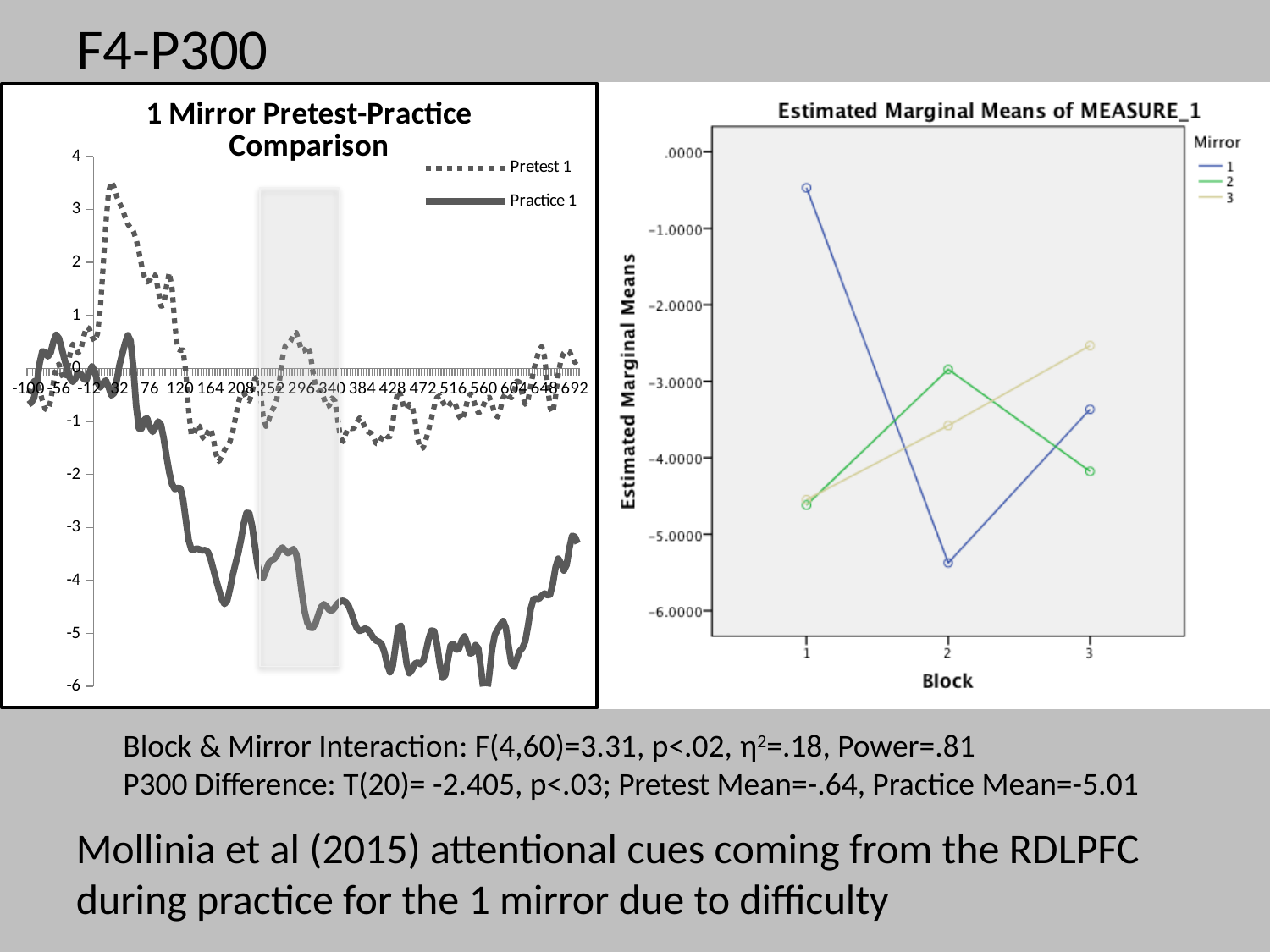
In the right chart 'Estimated Marginal Means of MEASURE_1', does the Mirror 3 line rise or fall from Block 1 to Block 3? rise How many series does the legend of the left chart '1 Mirror Pretest-Practice Comparison' list? 2 In the left chart '1 Mirror Pretest-Practice Comparison', which series reaches the lowest value overall? Practice 1 How many Block categories are shown on the x axis of the right chart 'Estimated Marginal Means of MEASURE_1'? 3 In the right chart 'Estimated Marginal Means of MEASURE_1', which Mirror has the lowest value at Block 2? Mirror 1 What is the title of the chart on the right? Estimated Marginal Means of MEASURE_1 In the right chart 'Estimated Marginal Means of MEASURE_1', is the value for Mirror 1 at Block 2 greater or less than -5.0000? less What kind of chart is the '1 Mirror Pretest-Practice Comparison' chart on the left? line chart In the right chart 'Estimated Marginal Means of MEASURE_1', which Mirror has the highest value at Block 3? Mirror 3 How many series does the Mirror legend list in the right chart 'Estimated Marginal Means of MEASURE_1'? 3 What are the two legend entries in the left chart '1 Mirror Pretest-Practice Comparison'? Pretest 1 and Practice 1 In the left chart '1 Mirror Pretest-Practice Comparison', is the value of Practice 1 at x = 692 greater or less than -4? greater